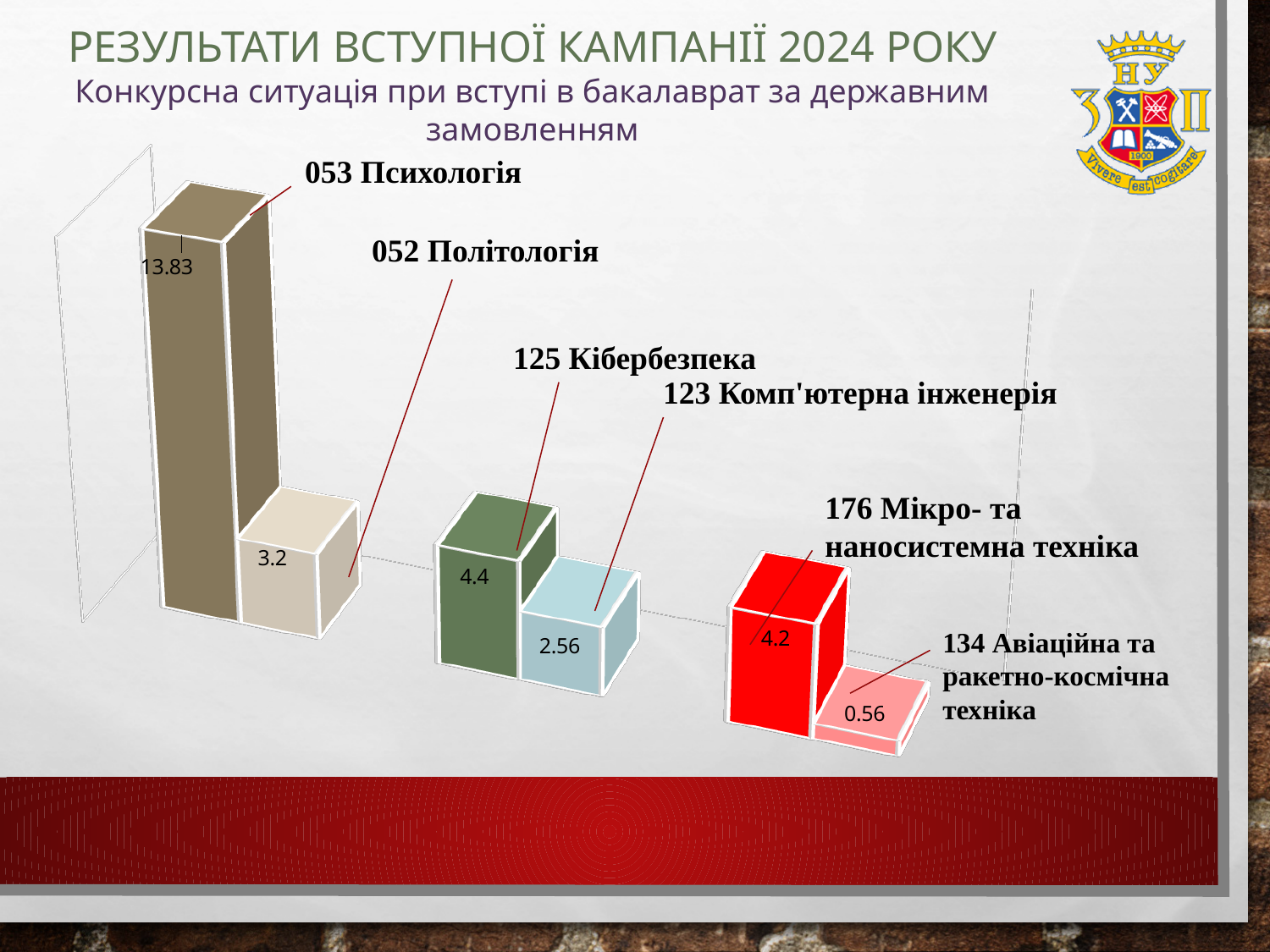
What is the difference between the values for 125 Кібербезпека and 123 Комп'ютерна інженерія? 1.84 What is the value shown for 123 Комп'ютерна інженерія? 2.56 Which category has the lowest value? 134 Авіаційна та ракетно-космічна техніка What is the value shown for 053 Психологія? 13.83 How many categories are shown in the chart? 6 What is the value shown for 134 Авіаційна та ракетно-космічна техніка? 0.56 What kind of chart is shown on the slide? Bar chart What is the value shown for 125 Кібербезпека? 4.4 Which has the larger value, 125 Кібербезпека or 176 Мікро- та наносистемна техніка? 125 Кібербезпека Which category has the highest value? 053 Психологія What is the value shown for 052 Політологія? 3.2 What is the difference between the values for 053 Психологія and 052 Політологія? 10.63